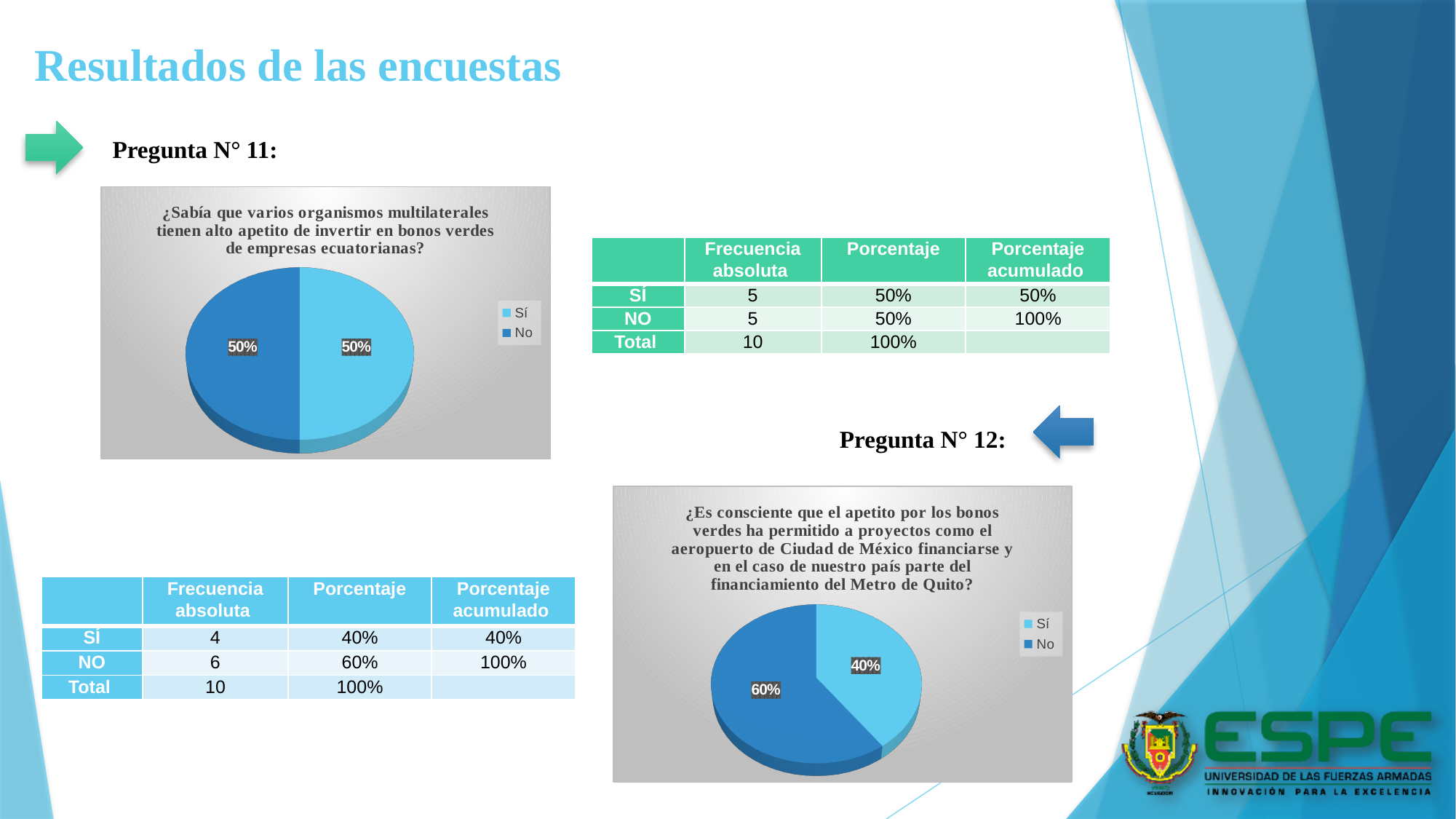
How many slices does the Pregunta N° 12 pie chart (bottom right) have? 2 How many entries does the legend of the Pregunta N° 11 pie chart (top left) list? 2 In the Pregunta N° 12 pie chart (bottom right), what share is labelled for Sí? 40% In the Pregunta N° 12 pie chart (bottom right), what is the difference between the No share and the Sí share? 20% What type of chart is used for Pregunta N° 11 (top left)? Pie chart In the Pregunta N° 12 pie chart (bottom right), which is larger, the Sí slice or the No slice? No In the Pregunta N° 12 pie chart (bottom right), what share is labelled for No? 60% In the Pregunta N° 12 pie chart (bottom right), which legend entry is shown in the darker blue colour? No In the Pregunta N° 12 pie chart (bottom right), which slice is the smallest? Sí In the Pregunta N° 11 pie chart (top left), what share is labelled for Sí? 50% In the Pregunta N° 12 pie chart (bottom right), which slice is the largest? No